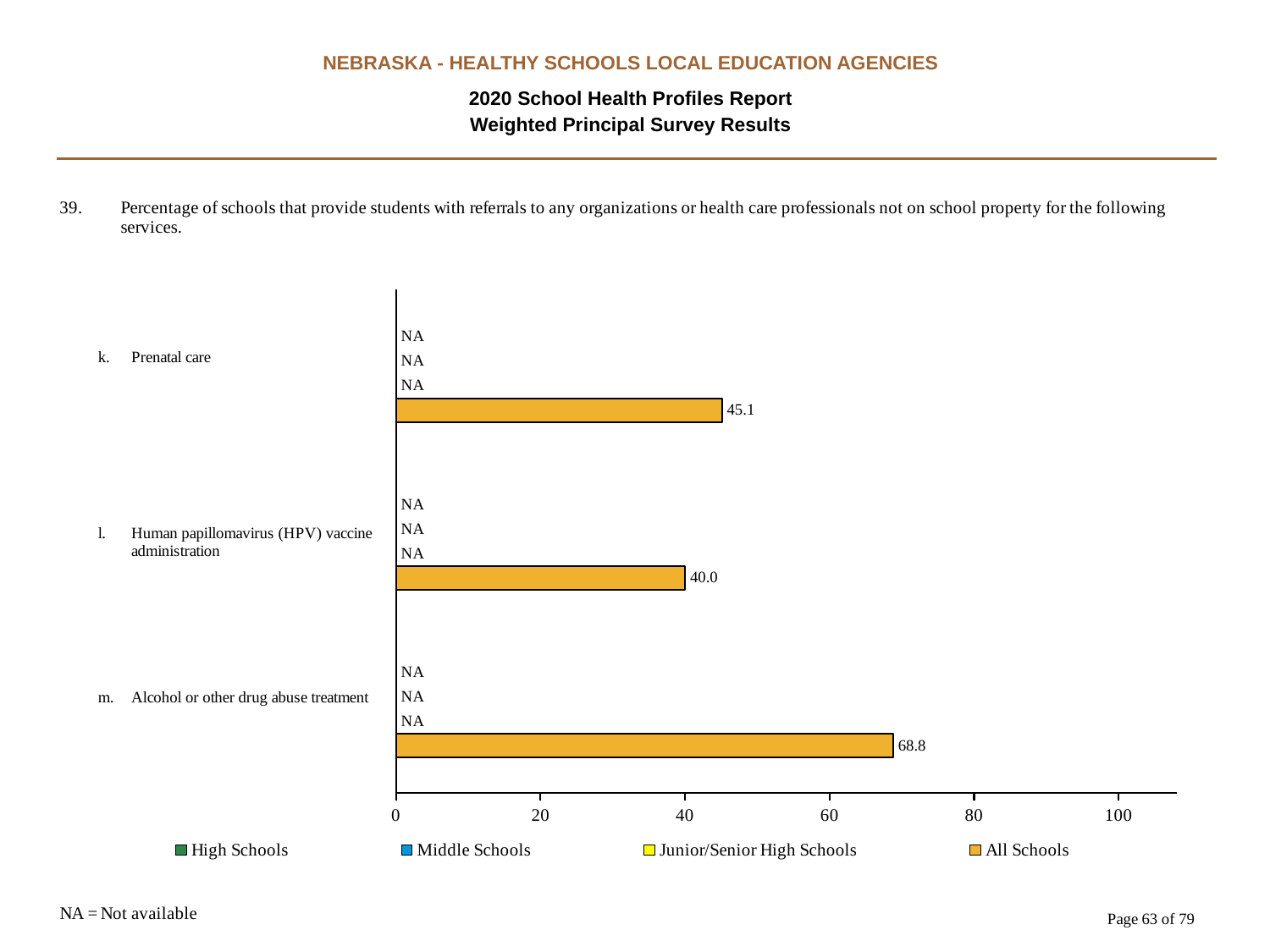
What is the difference between the All Schools values for Alcohol or other drug abuse treatment and Prenatal care? 23.7 What is the All Schools value for Human papillomavirus (HPV) vaccine administration? 40.0 What kind of chart is shown on the slide? Bar chart Is the All Schools value for Alcohol or other drug abuse treatment greater or less than 60? greater Which is larger for All Schools: Prenatal care or Human papillomavirus (HPV) vaccine administration? Prenatal care What is the All Schools value for Prenatal care? 45.1 Which service has the lowest All Schools value? Human papillomavirus (HPV) vaccine administration Which service has the highest All Schools value? Alcohol or other drug abuse treatment How many series does the legend list? 4 What is the All Schools value for Alcohol or other drug abuse treatment? 68.8 What value is shown for High Schools for Prenatal care? NA How many services (categories) are shown on the chart? 3